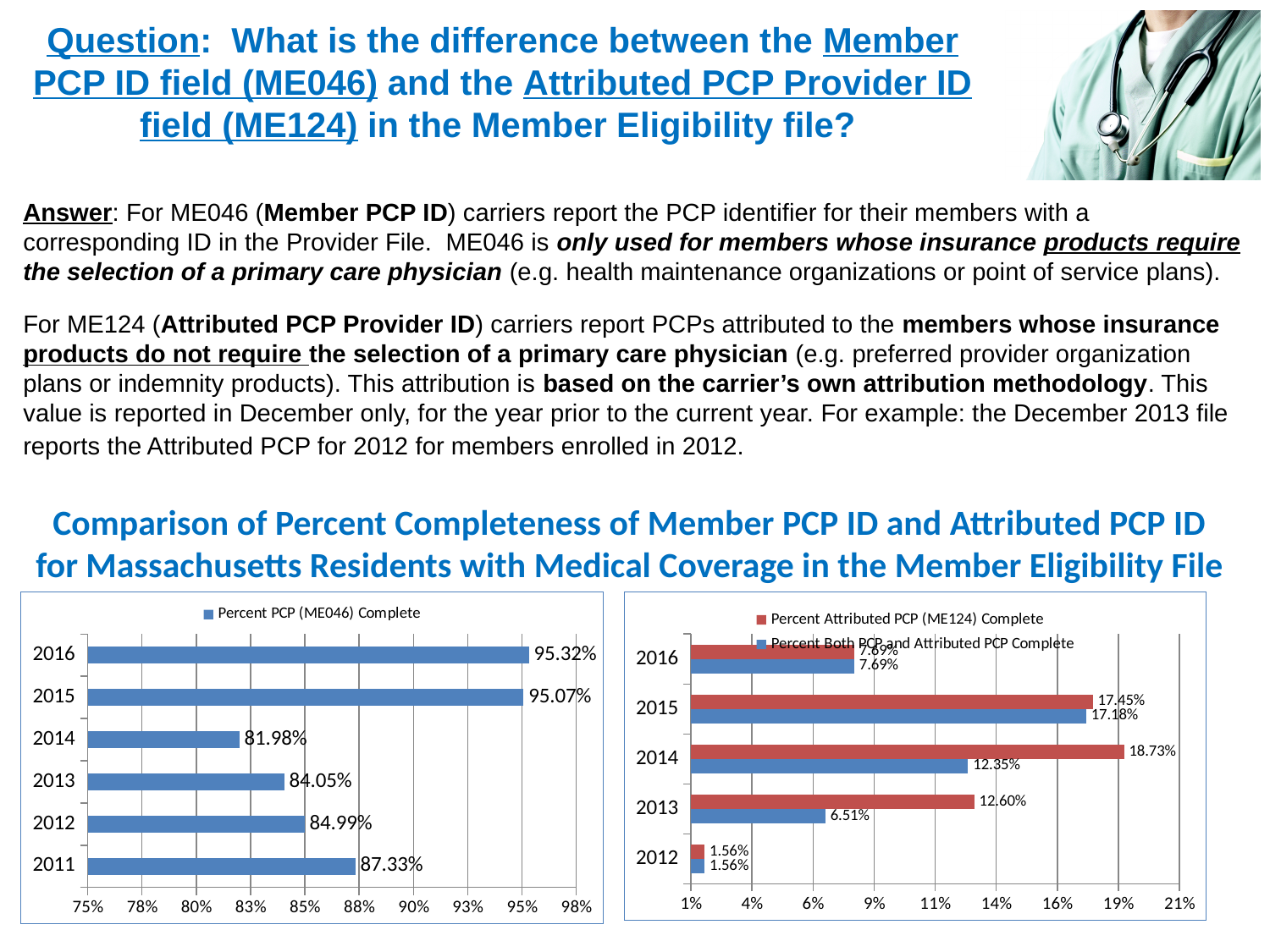
In the right chart, which year has the highest Percent Attributed PCP (ME124) Complete value? 2014 In the left chart (Percent PCP (ME046) Complete), how many years are plotted? 6 In the left chart (Percent PCP (ME046) Complete), which year has the lowest value? 2014 In the left chart (Percent PCP (ME046) Complete), what is the value for 2011? 87.33% In the right chart, what is the Percent Attributed PCP (ME124) Complete value for 2014? 18.73% How many series does the legend of the right chart list? 2 In the left chart (Percent PCP (ME046) Complete), which year has the highest value? 2016 In the right chart, what is the Percent Both PCP and Attributed PCP Complete value for 2013? 6.51% In the left chart (Percent PCP (ME046) Complete), what is the value for 2014? 81.98% In the right chart, which is larger for 2013: Percent Attributed PCP (ME124) Complete or Percent Both PCP and Attributed PCP Complete? Percent Attributed PCP (ME124) Complete In the left chart (Percent PCP (ME046) Complete), what is the difference between the 2016 value and the 2015 value? 0.25% What type of chart is the left chart? Bar chart